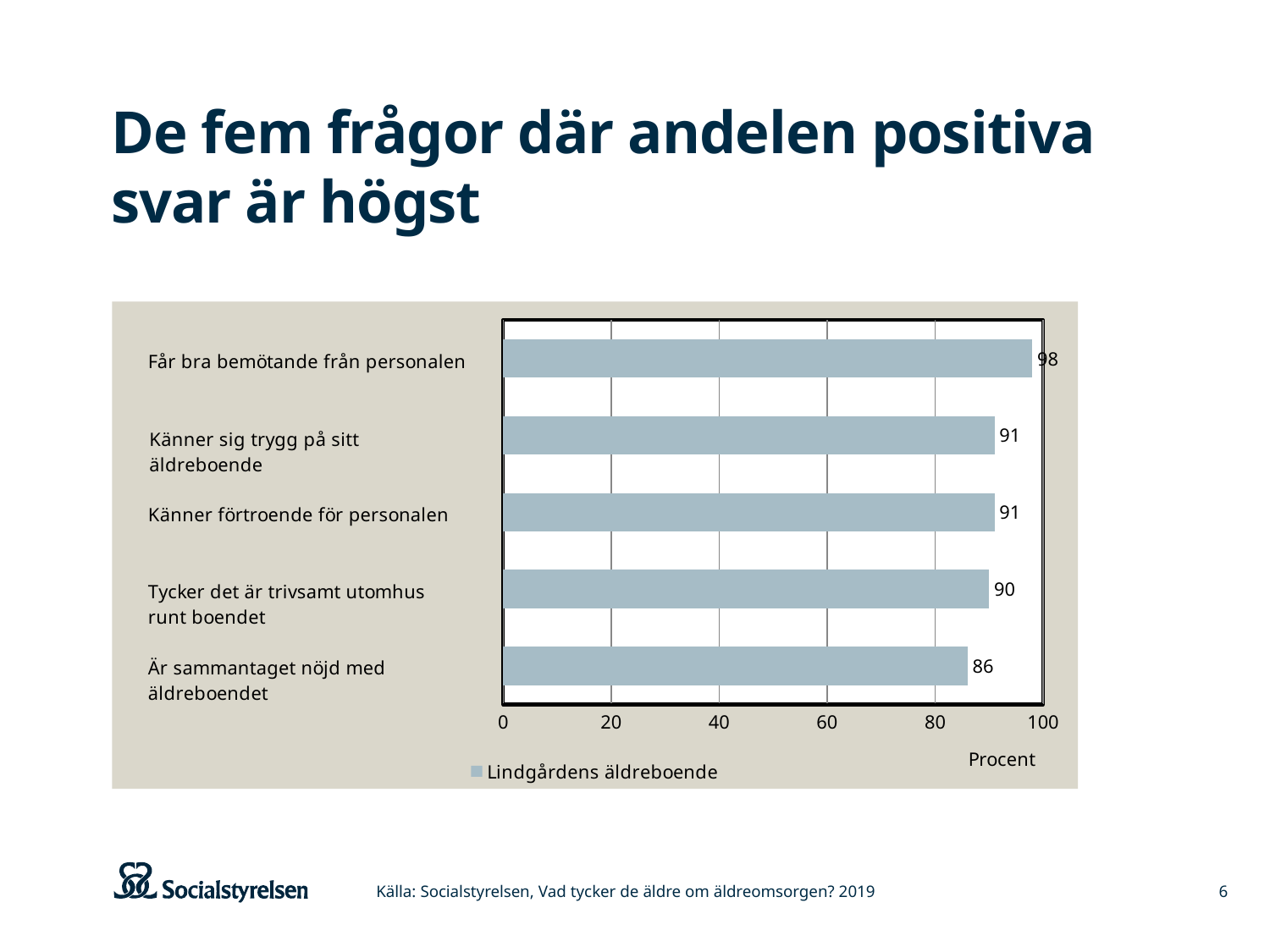
What is the value for "Känner sig trygg på sitt äldreboende"? 91 Which category has the highest value? Får bra bemötande från personalen What kind of chart is shown on the slide? bar chart What is the value for "Tycker det är trivsamt utomhus runt boendet"? 90 How many categories are shown in the chart? 5 What series name does the legend show? Lindgårdens äldreboende What is the value for "Är sammantaget nöjd med äldreboendet"? 86 What is the difference between the values for "Får bra bemötande från personalen" and "Är sammantaget nöjd med äldreboendet"? 12 What is the value for "Får bra bemötande från personalen"? 98 Which is larger: the value for "Känner förtroende för personalen" or the value for "Är sammantaget nöjd med äldreboendet"? Känner förtroende för personalen Which category has the lowest value? Är sammantaget nöjd med äldreboendet Is the value for "Är sammantaget nöjd med äldreboendet" greater or less than 80? greater